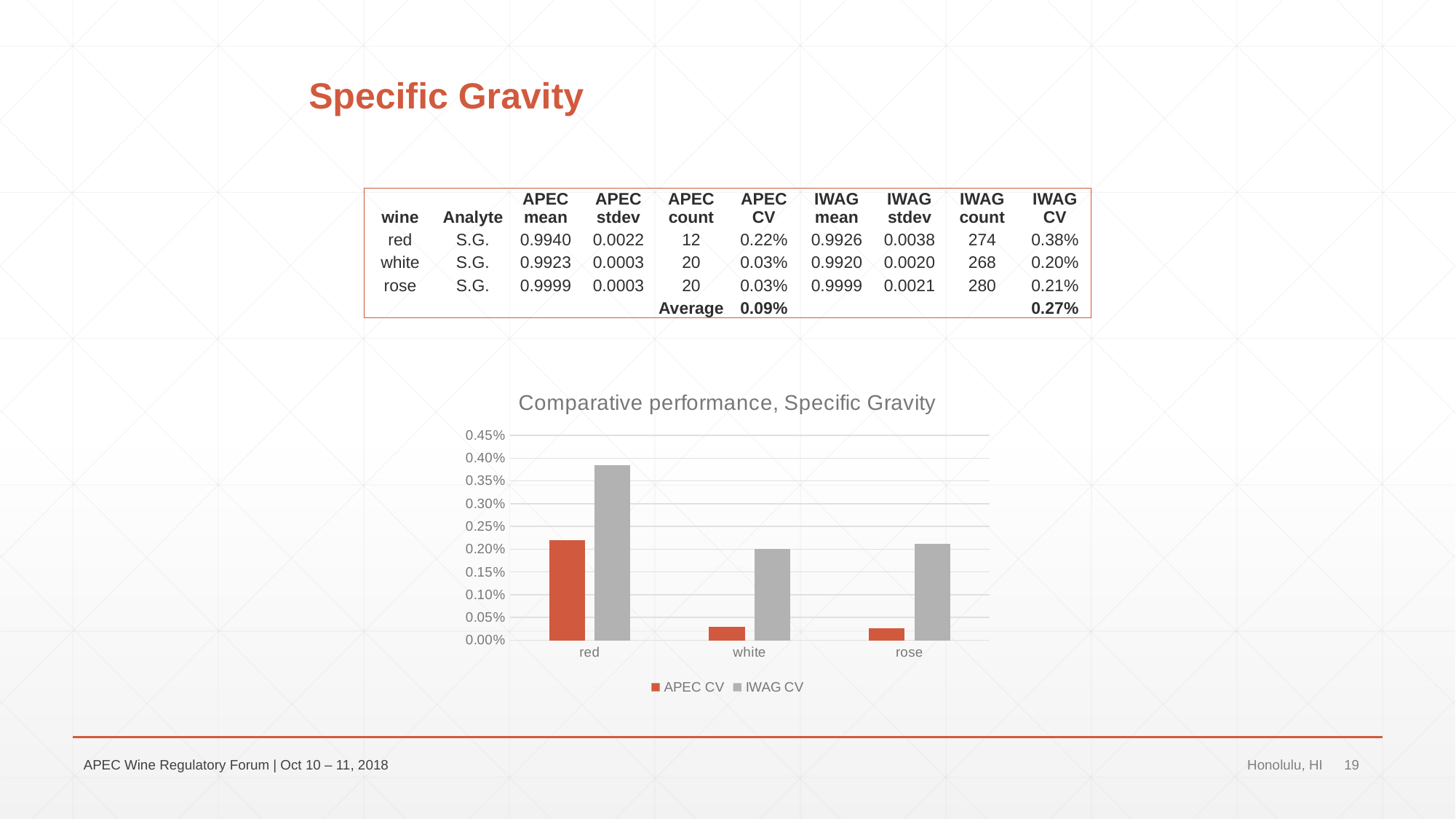
Which wine has the highest APEC CV in the chart? red For red wine, which is larger in the chart: APEC CV or IWAG CV? IWAG CV How many series does the chart legend list? 2 Is the APEC CV bar for white greater or less than 0.05%? less Which wine has the highest IWAG CV in the chart? red What is the difference between the IWAG CV and APEC CV for white wine? 0.17% How many wine categories are shown on the x axis of the chart? 3 What type of chart is shown on the slide? bar chart What is the title of the chart? Comparative performance, Specific Gravity What is the APEC CV value for red wine? 0.22% Is the IWAG CV bar for red greater or less than 0.35%? greater